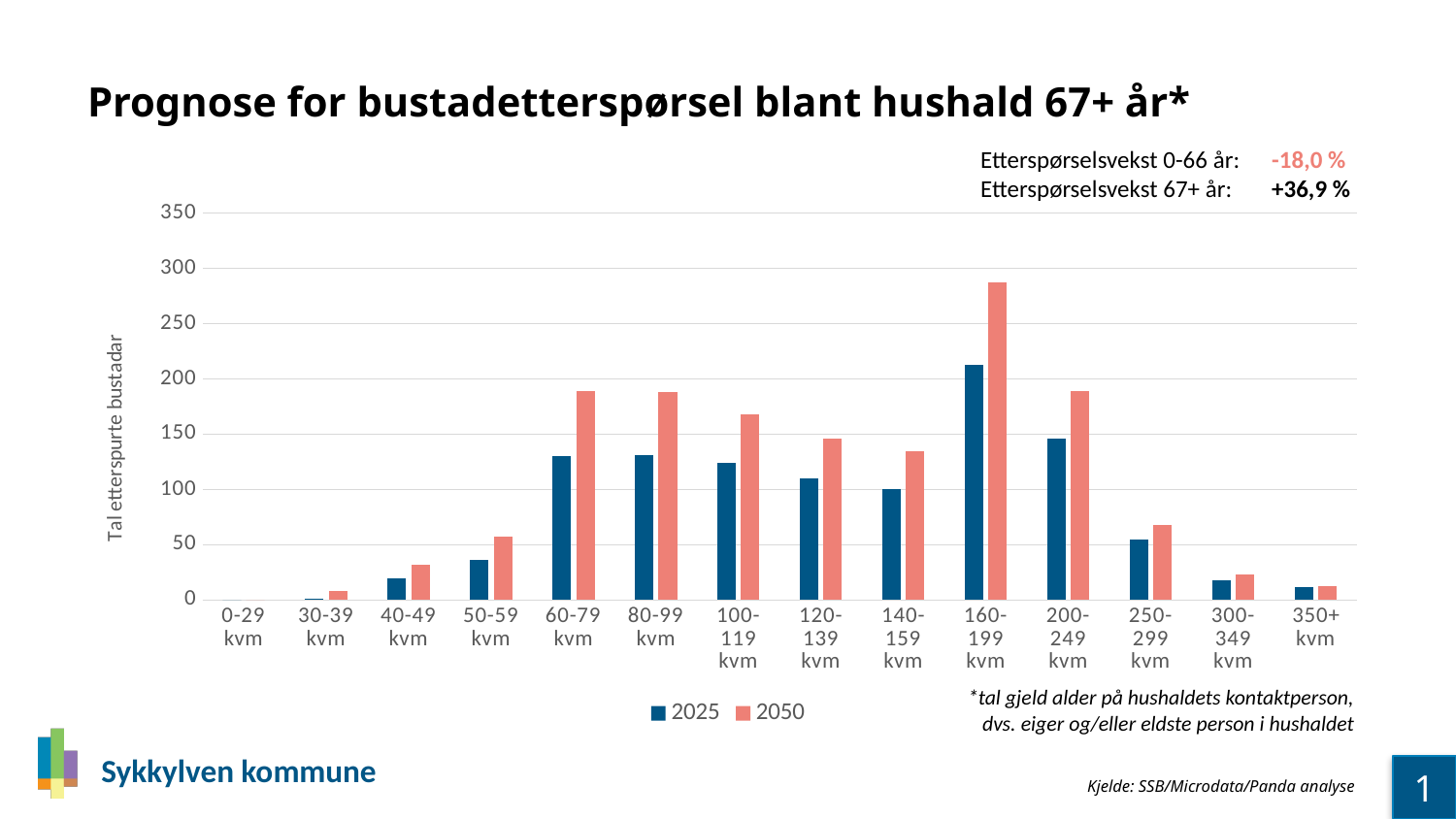
What kind of chart is shown on the slide? Bar chart Which size category has the highest value for the 2050 series? 160-199 kvm How many series does the legend list? 2 For the 200-249 kvm category, which series has the larger value, 2025 or 2050? 2050 What is the label on the vertical axis of the chart? Tal etterspurte bustadar How many size categories are shown on the x axis? 14 Is the 2025 value for 160-199 kvm greater or less than 200? greater Which size category has the highest value for the 2025 series? 160-199 kvm Is the 2025 value for 300-349 kvm greater or less than 50? less Is the 2050 value for 160-199 kvm greater or less than 250? greater For the 2025 series, which is larger: the value for 60-79 kvm or the value for 250-299 kvm? 60-79 kvm